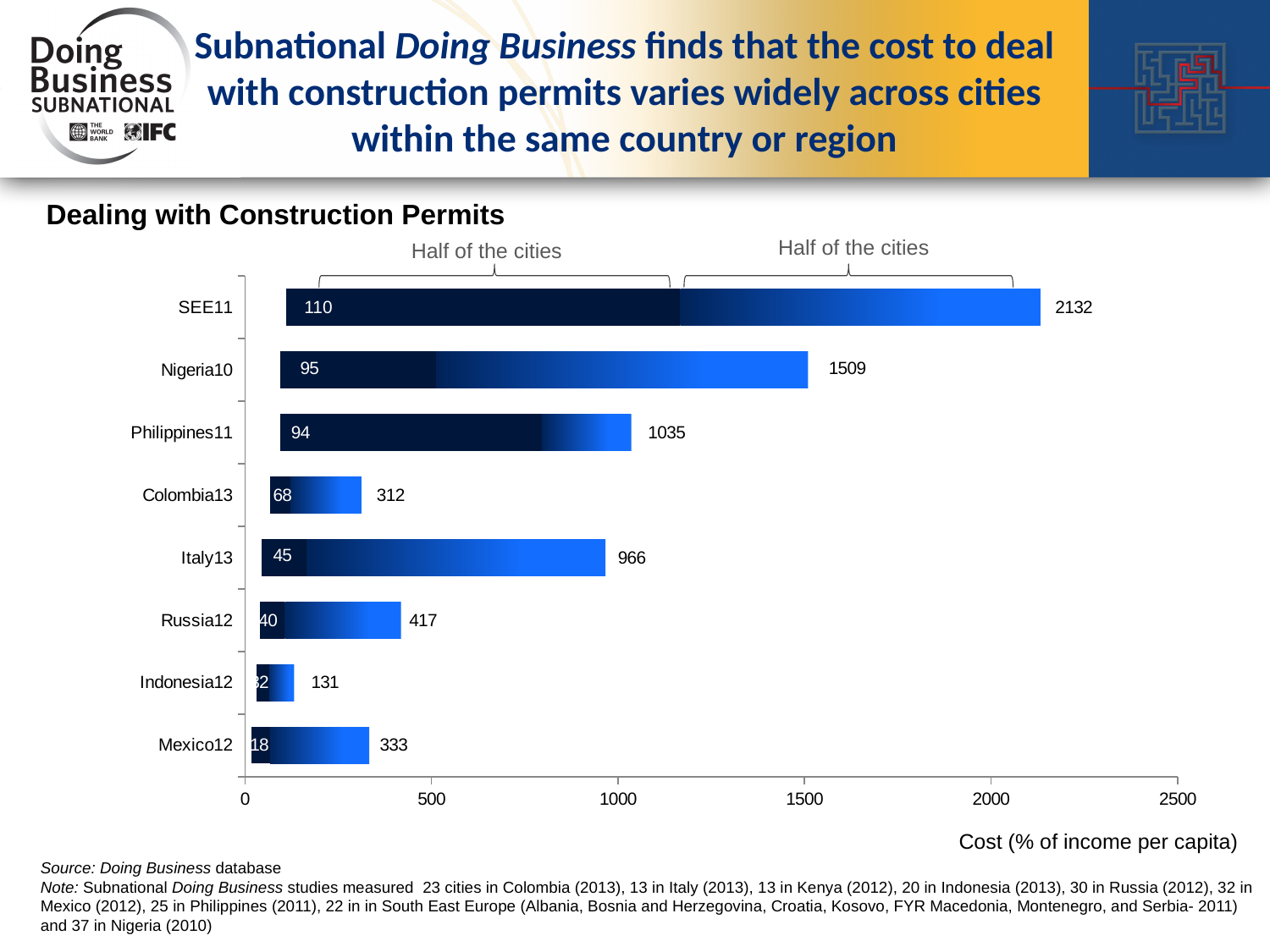
How many countries or regions are listed on the chart? 8 What is the highest cost value shown for Mexico12? 333 What is the label of the horizontal axis? Cost (% of income per capita) What is the difference between the maximum cost for SEE11 and the maximum cost for Nigeria10? 623 What is the highest cost value shown for SEE11? 2132 What is the difference between the maximum and minimum cost values for Colombia13? 244 Is the maximum cost value for Russia12 greater or less than 500? less Which has a larger maximum cost value, Italy13 or Philippines11? Philippines11 What kind of chart is shown on the slide? bar chart Which country or region has the highest maximum cost value? SEE11 Which country or region has the lowest maximum cost value? Indonesia12 What is the lowest cost value shown for Nigeria10? 95